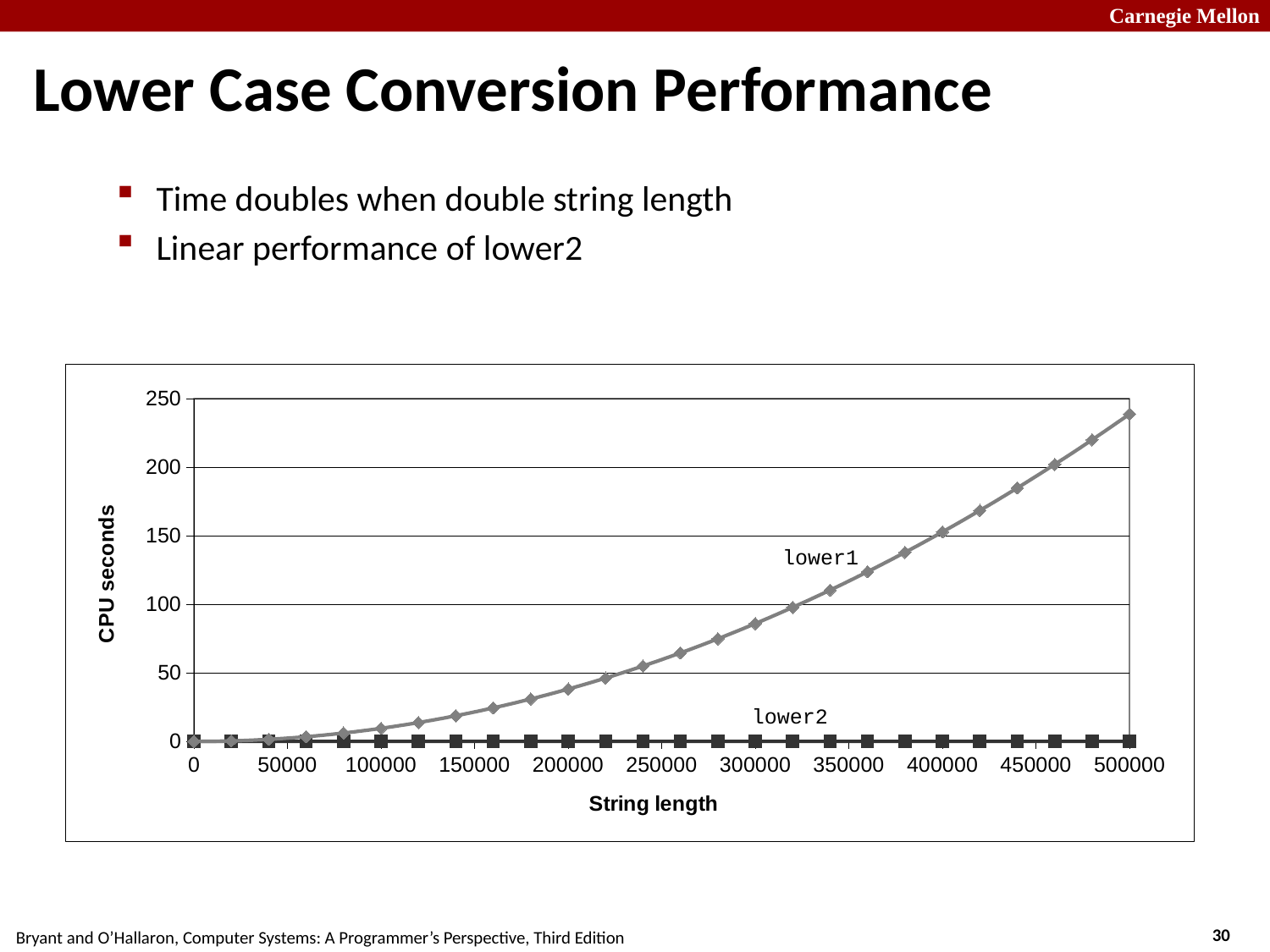
Is the value for lower1 at string length 300000 greater or less than 100? less What is the label of the y axis? CPU seconds What are the names of the two series labelled on the chart? lower1 and lower2 How many data series are plotted on the chart? 2 Which series has the highest CPU seconds value on the chart? lower1 How many tick labels are shown on the x axis? 11 What kind of chart is shown on the slide? line chart Does the lower1 series rise or fall as string length increases? rise Is the value for lower2 at string length 500000 greater or less than 50? less At string length 500000, which series has the larger CPU seconds value, lower1 or lower2? lower1 Is the value for lower1 at string length 200000 greater or less than 50? less